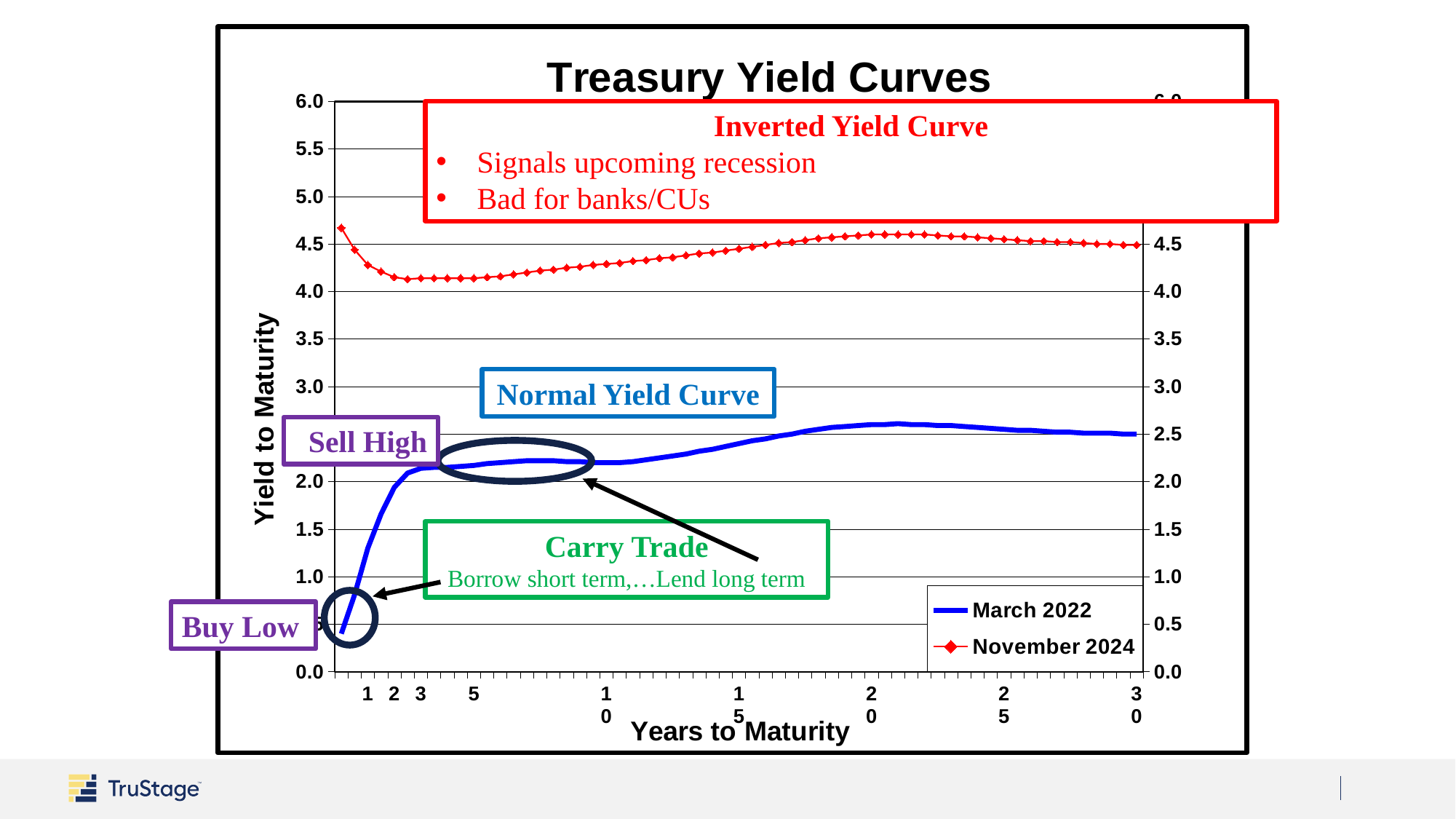
Does the November 2024 curve rise or fall between 1 and 3 years to maturity? fall Which series has the higher yield at 10 years to maturity, March 2022 or November 2024? November 2024 How many series does the legend list? 2 What kind of chart is shown on the slide? line chart Is the November 2024 yield at 5 years to maturity greater or less than 4.0? greater Is the March 2022 yield at 1 year to maturity greater or less than 1.0? greater Is the March 2022 yield at 10 years to maturity greater or less than 2.0? greater Does the March 2022 curve rise or fall between 1 and 5 years to maturity? rise Which series is drawn in red with diamond markers? November 2024 What is the title of the chart? Treasury Yield Curves